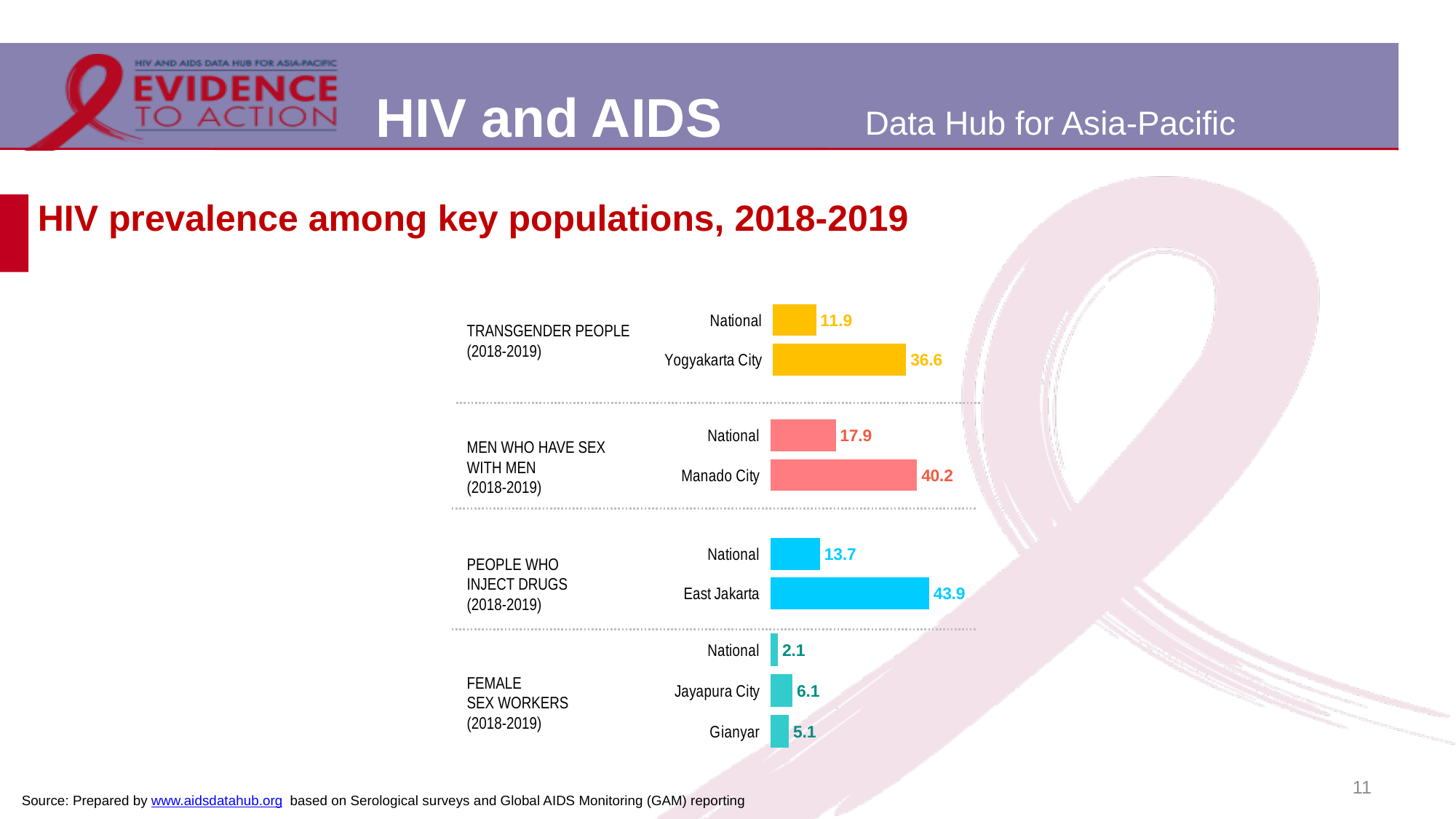
Which bar in the chart has the lowest value? National (female sex workers) What is the difference between the Manado City value and the national value for men who have sex with men? 22.3 What is the difference between the Jayapura City value and the Gianyar value for female sex workers? 1.0 How many bars are plotted in the chart in total? 9 What is the HIV prevalence value shown for Yogyakarta City among transgender people? 36.6 What colour are the bars for the female sex workers group? Teal Which bar in the chart has the highest value? East Jakarta (people who inject drugs) What is the national HIV prevalence value shown for men who have sex with men? 17.9 What is the HIV prevalence value shown for Gianyar among female sex workers? 5.1 Which is larger: the national value for transgender people or the national value for people who inject drugs? People who inject drugs (13.7) What type of chart is shown on the slide? Bar chart What is the HIV prevalence value shown for East Jakarta among people who inject drugs? 43.9